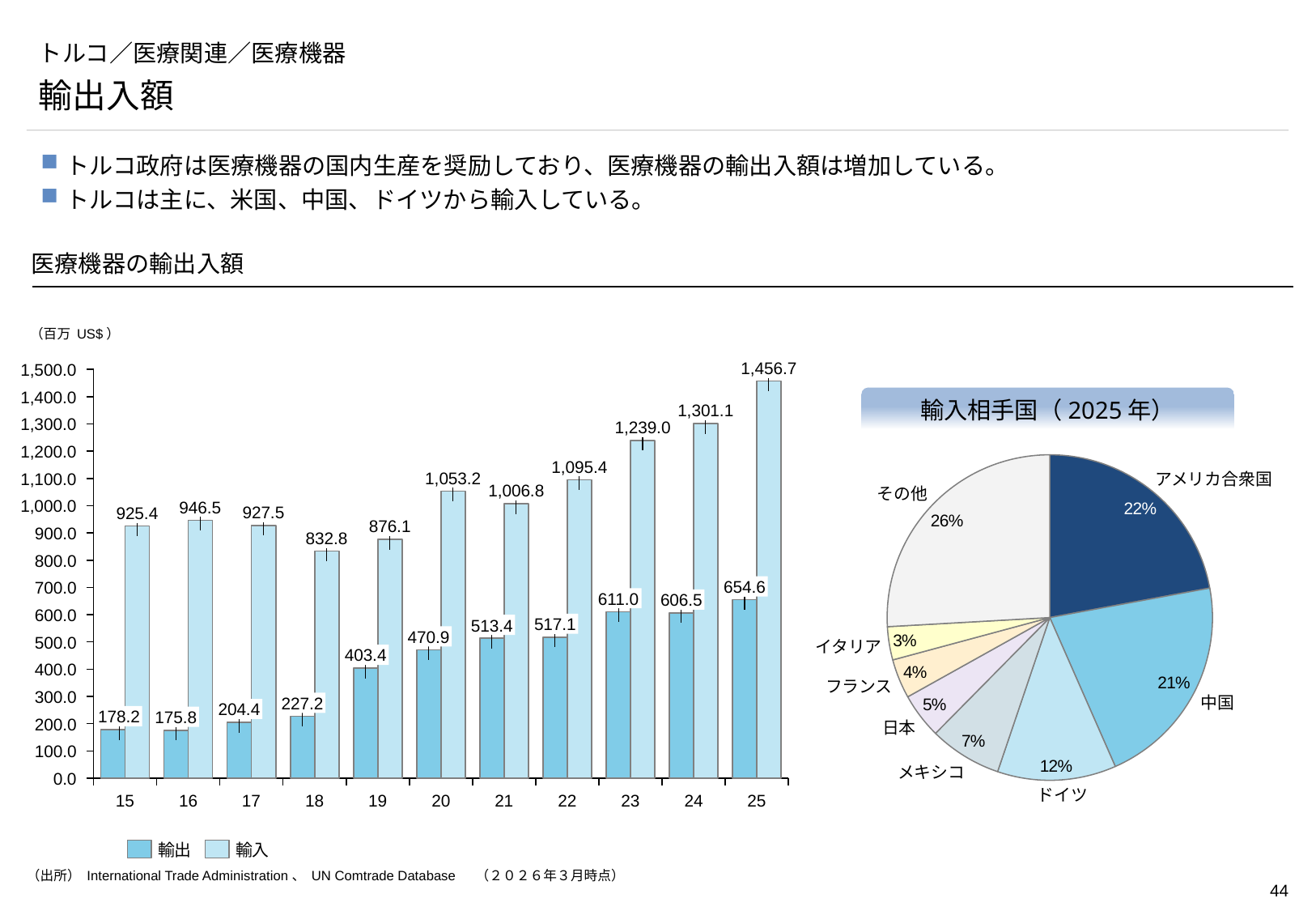
「輸入相手国（2025年）」の円グラフで、その他を除いて最も割合が小さい国はどこですか？ イタリア 「医療機器の輸出入額」のグラフで、輸入は20年から25年にかけて増加していますか、減少していますか？ 増加 「輸入相手国（2025年）」の円グラフには、いくつの区分がありますか？ 8 「医療機器の輸出入額」のグラフで、輸出が最も多い年はどれですか？ 25 「医療機器の輸出入額」のグラフで、25年の輸入と輸出の差はいくらですか？ 802.1 「医療機器の輸出入額」のグラフで、25年の輸入の値はいくらですか？ 1,456.7 「輸入相手国（2025年）」の円グラフで、中国の割合は何％ですか？ 21% 「医療機器の輸出入額」のグラフで、23年と24年では輸出はどちらが大きいですか？ 23 「医療機器の輸出入額」のグラフで、輸入が最も少ない年はどれですか？ 18 「医療機器の輸出入額」のグラフは何の種類のグラフですか？ 棒グラフ 「医療機器の輸出入額」のグラフで、凡例にはいくつの系列がありますか？ 2 「医療機器の輸出入額」のグラフで、19年の輸出の値はいくらですか？ 403.4